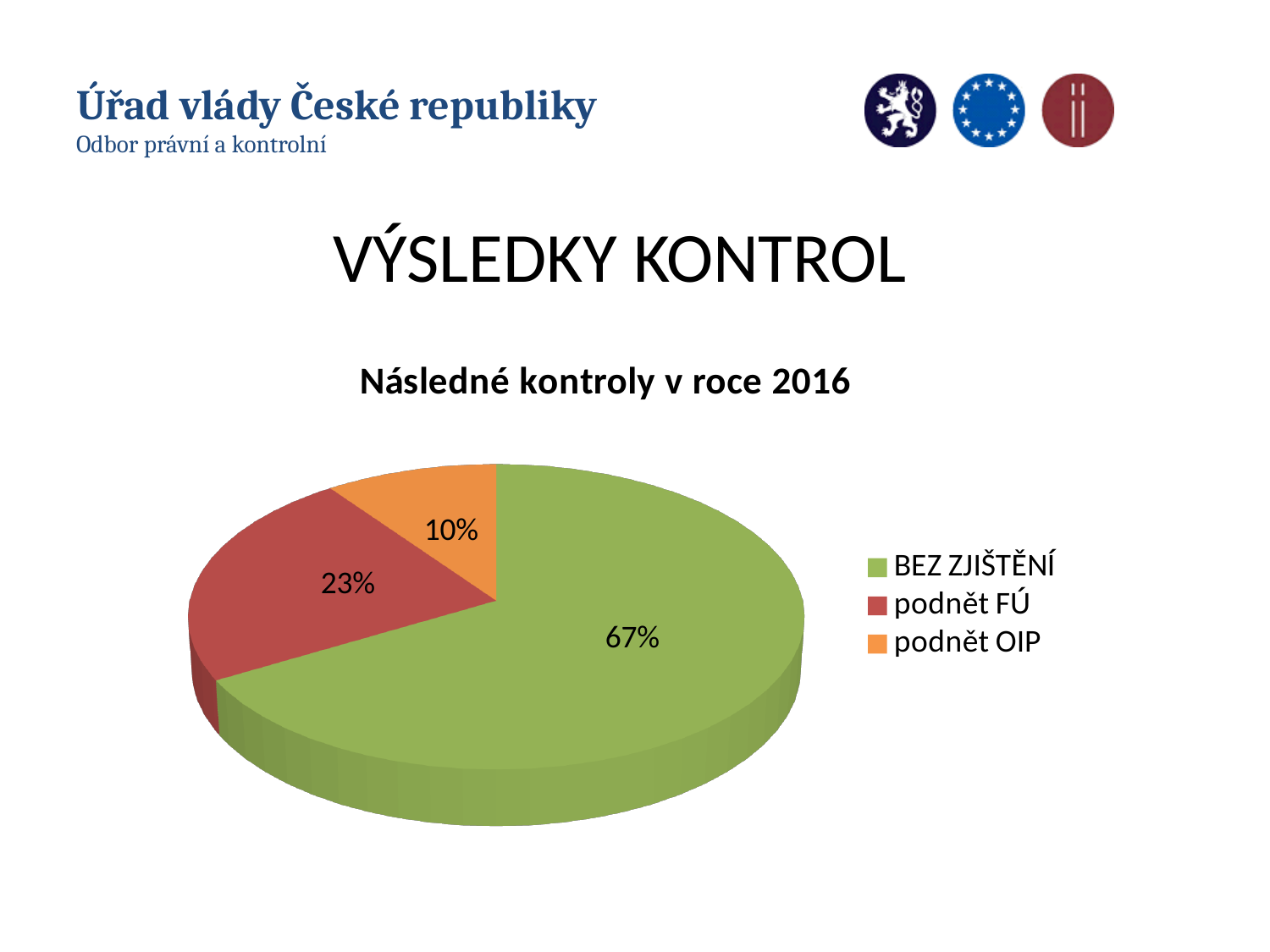
Which category has the largest slice of the pie? BEZ ZJIŠTĚNÍ How many categories are shown in the pie chart? 3 What is the difference in percentage points between BEZ ZJIŠTĚNÍ and podnět FÚ? 44 What is the difference in percentage points between podnět FÚ and podnět OIP? 13 Which category has the smallest slice of the pie? podnět OIP What kind of chart is shown on the slide? Pie chart What share of the pie does podnět FÚ represent? 23% Which is larger, the share for podnět FÚ or the share for podnět OIP? podnět FÚ What share of the pie does BEZ ZJIŠTĚNÍ represent? 67% What share of the pie does podnět OIP represent? 10% What is the title of the chart? Následné kontroly v roce 2016 Which colour represents podnět OIP in the chart? Orange